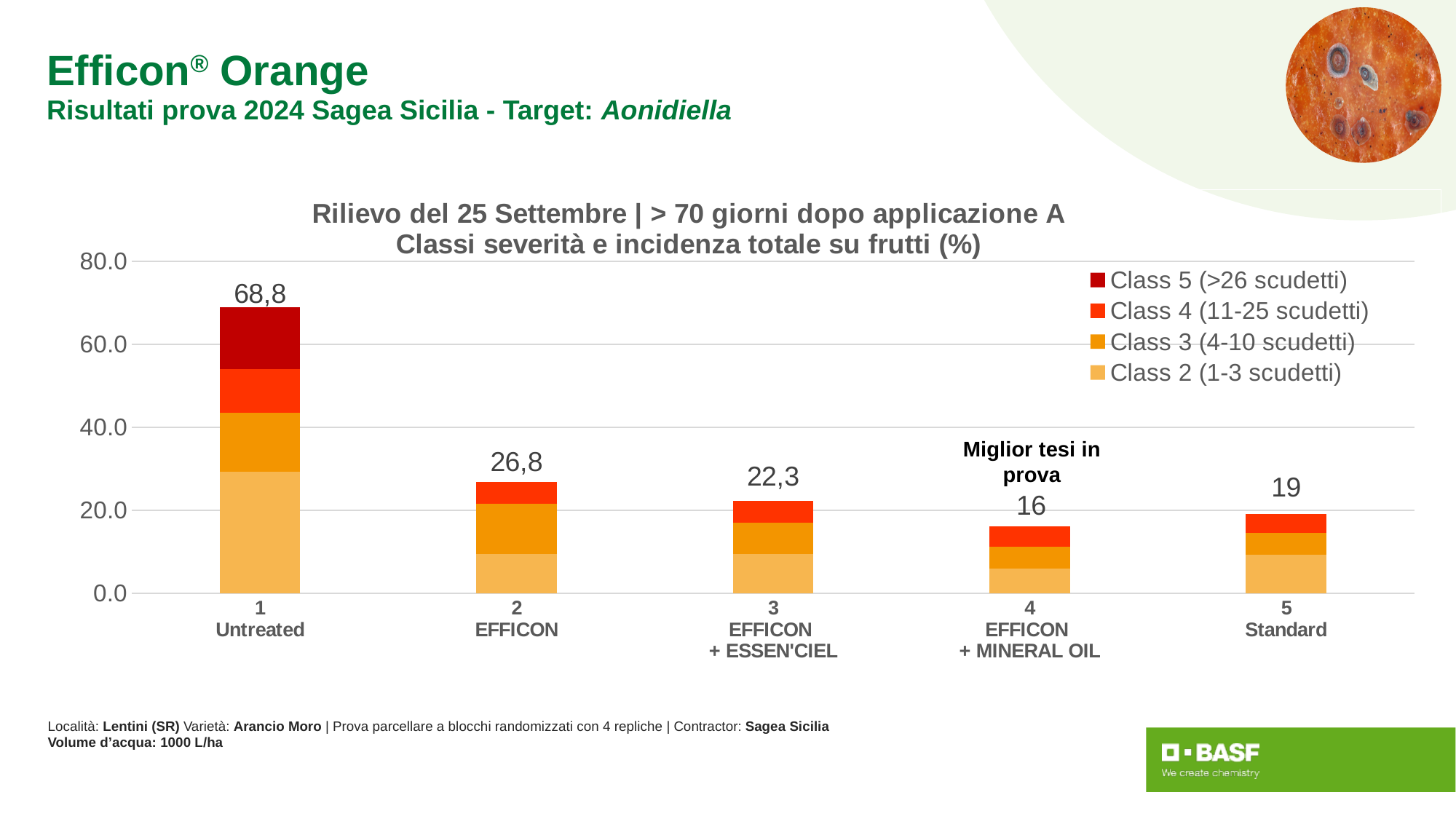
Which has a larger total incidence, EFFICON + ESSEN'CIEL or Standard? EFFICON + ESSEN'CIEL How many treatment categories are shown on the x axis? 5 Which treatment is annotated as 'Miglior tesi in prova'? EFFICON + MINERAL OIL Is the total value for EFFICON greater or less than 20.0? greater What is the total value labelled above the EFFICON + MINERAL OIL bar? 16 How many severity classes does the legend list? 4 What is the difference between the total for Untreated and the total for EFFICON? 42 What kind of chart is shown on the slide? Stacked bar chart What is the total incidence value shown for the Untreated bar? 68,8 What is the total value labelled above the Standard bar? 19 Which treatment has the lowest total incidence on fruit? EFFICON + MINERAL OIL Which treatment has the highest total incidence on fruit? Untreated